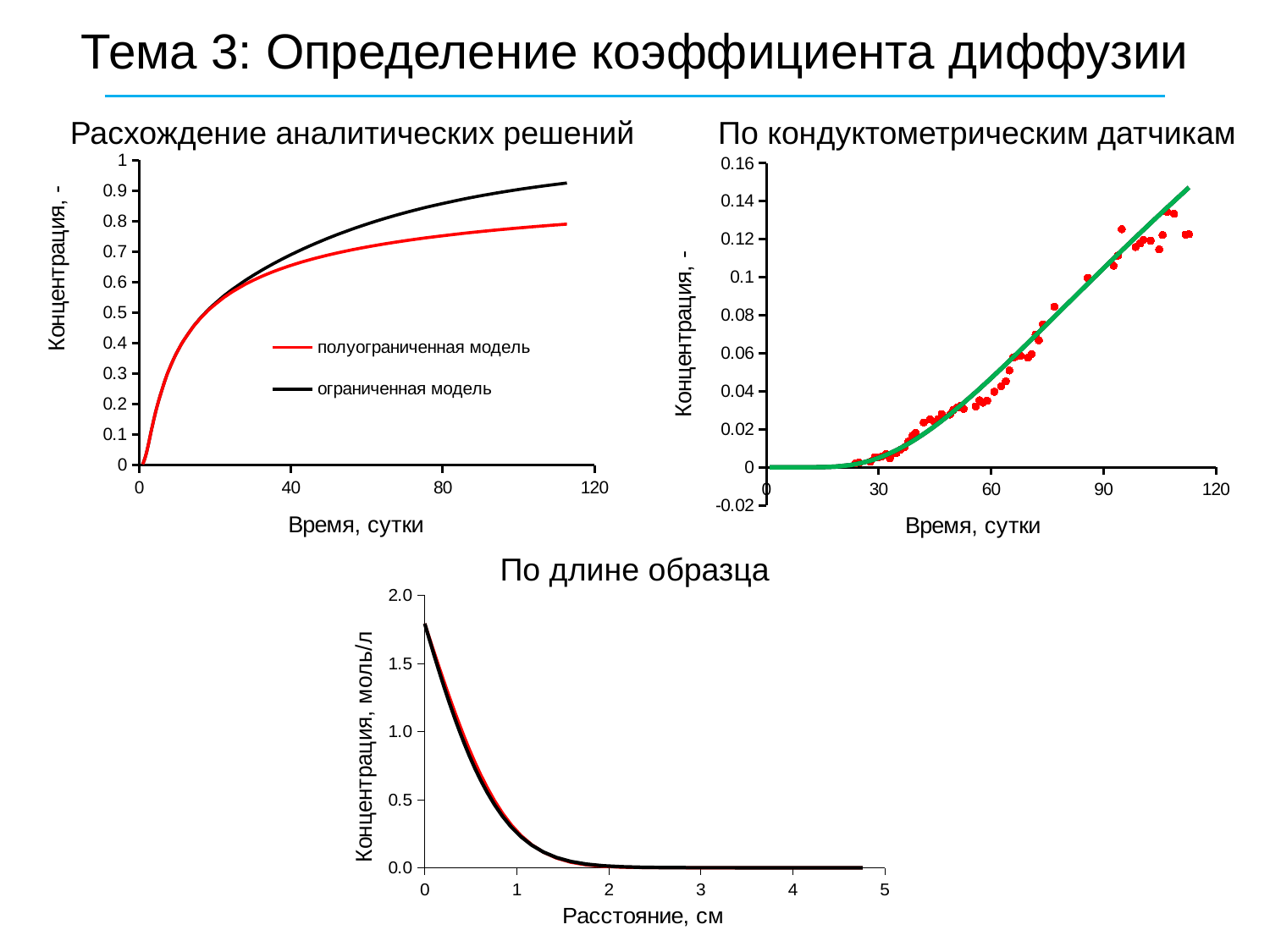
How many series does the legend of the top-left chart "Расхождение аналитических решений" list? 2 In the top-left chart "Расхождение аналитических решений", is the value of "ограниченная модель" at 80 days greater or less than 0.8? greater In the top-left chart "Расхождение аналитических решений", is the value of "полуограниченная модель" at 80 days greater or less than 0.8? less In the bottom chart "По длине образца", is the concentration at a distance of 1 cm greater or less than 0.5? less In the top-left chart "Расхождение аналитических решений", which series has the higher value at the right end of the curves, "полуограниченная модель" or "ограниченная модель"? ограниченная модель What is the x-axis label of the bottom chart "По длине образца"? Расстояние, см What kind of chart is the top-left chart titled "Расхождение аналитических решений"? line chart In the top-left chart "Расхождение аналитических решений", which colour is the line for "полуограниченная модель"? red In the top-left chart "Расхождение аналитических решений", do the values rise or fall as time increases? rise In the top-right chart "По кондуктометрическим датчикам", do the values rise or fall as time increases? rise In the bottom chart "По длине образца", do the values rise or fall as distance increases? fall